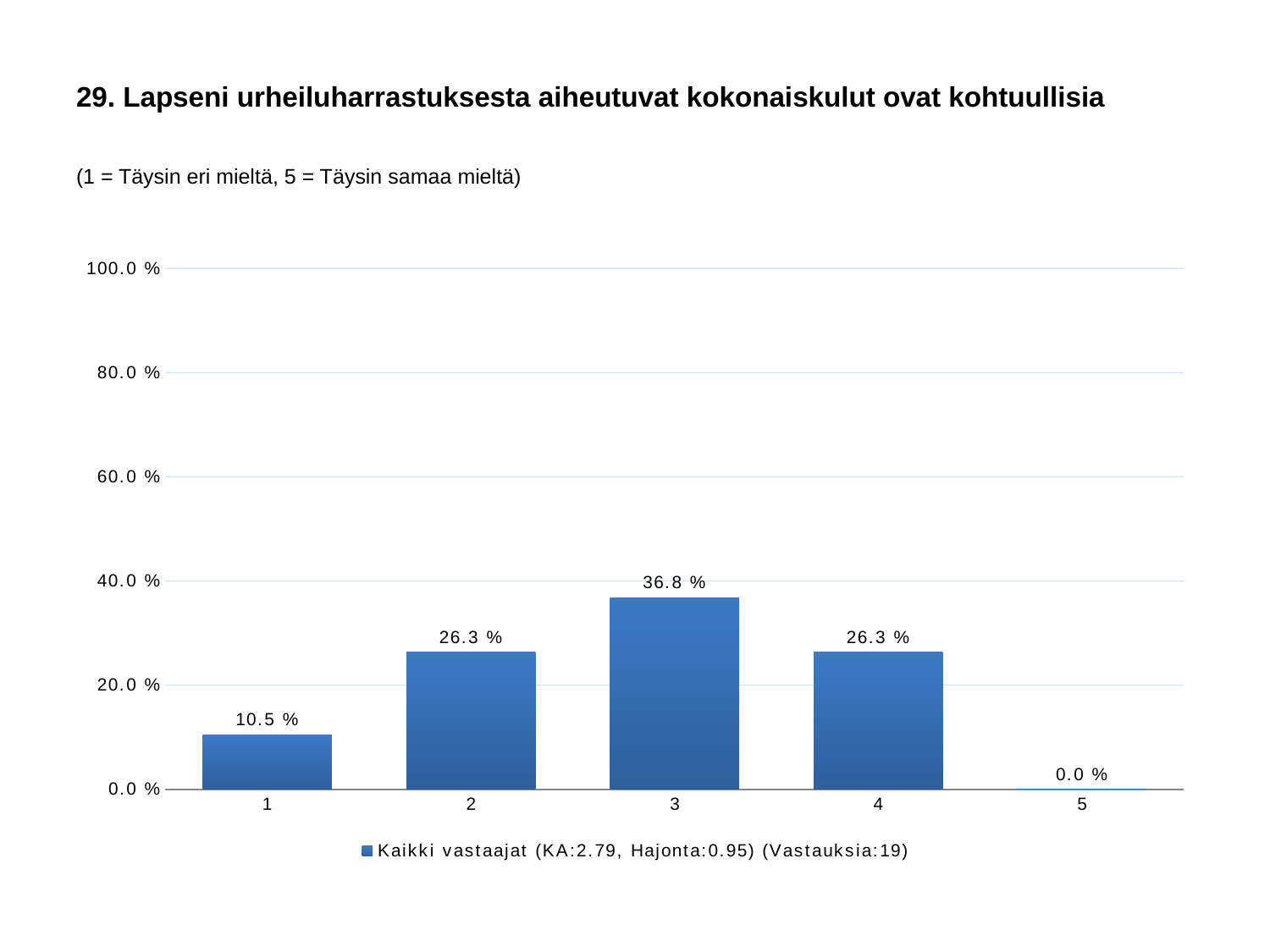
What is the value for category 3? 36.8 % What is the difference between the values for category 2 and category 1? 15.8 % Which category has the lowest value? 5 Which category has the highest value? 3 What is the difference between the values for category 3 and category 2? 10.5 % Is the value for category 3 greater or less than 40.0 %? less What is the value for category 1? 10.5 % How many responses (Vastauksia) does the legend report? 19 Which is larger, the value for category 1 or the value for category 4? 4 How many categories are shown on the x axis? 5 What kind of chart is shown on the slide? bar chart What is the value for category 5? 0.0 %